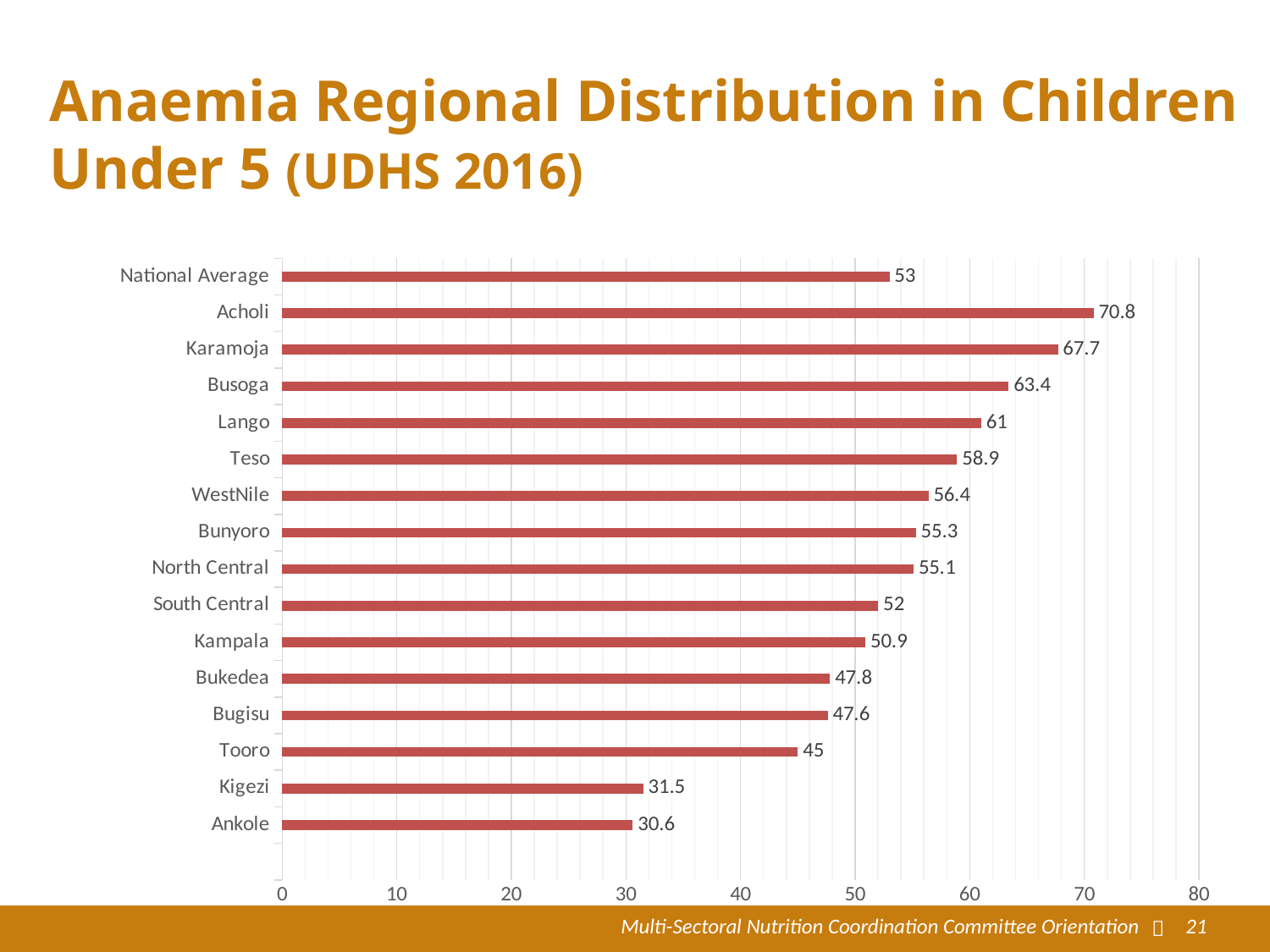
Which is larger, the value for Teso or the value for WestNile? Teso Which region has the highest value? Acholi Which region has the lowest value? Ankole What is the difference between the values for Karamoja and Busoga? 4.3 What is the value for the National Average? 53 What is the difference between the values for Acholi and Ankole? 40.2 Is the value for Lango greater or less than 60? greater How many bars are shown in the chart? 16 What is the title of the slide? Anaemia Regional Distribution in Children Under 5 (UDHS 2016) What kind of chart is shown on the slide? Bar chart What is the value for Kigezi? 31.5 What is the value for Acholi? 70.8